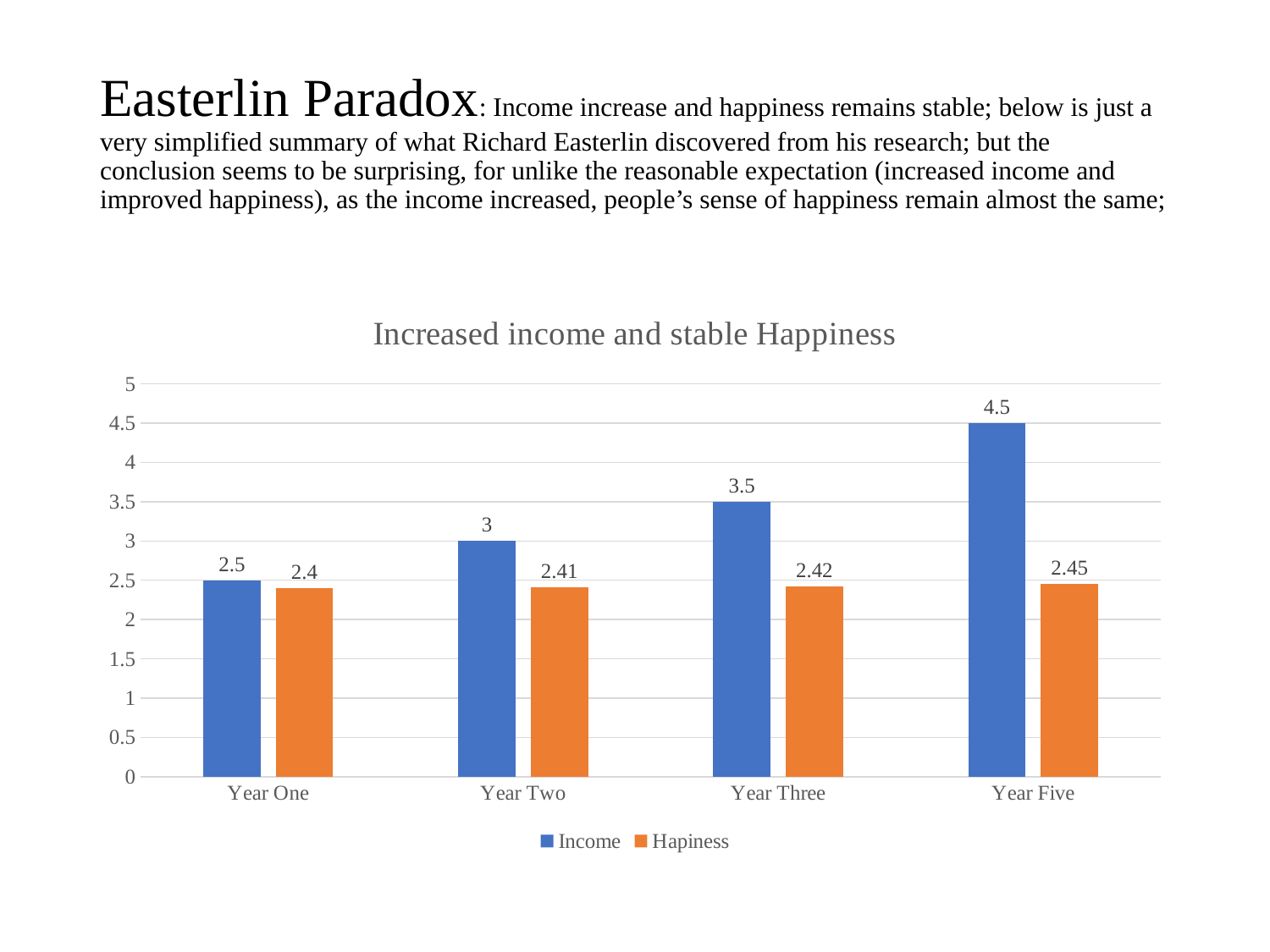
What is the difference between the Income values for Year Two and Year One? 0.5 Do the Income values rise or fall from Year One to Year Five? Rise What is the difference between the Income and Hapiness values for Year Five? 2.05 Which year has the lowest Income value? Year One What is the Income value for Year Three? 3.5 Which is larger for Year Three, the Income value or the Hapiness value? Income Which year has the highest Income value? Year Five How many series does the legend list? 2 What is the Hapiness value for Year Five? 2.45 What kind of chart is shown on the slide? Bar chart How many year categories are shown on the x axis? 4 What is the Hapiness value for Year Two? 2.41